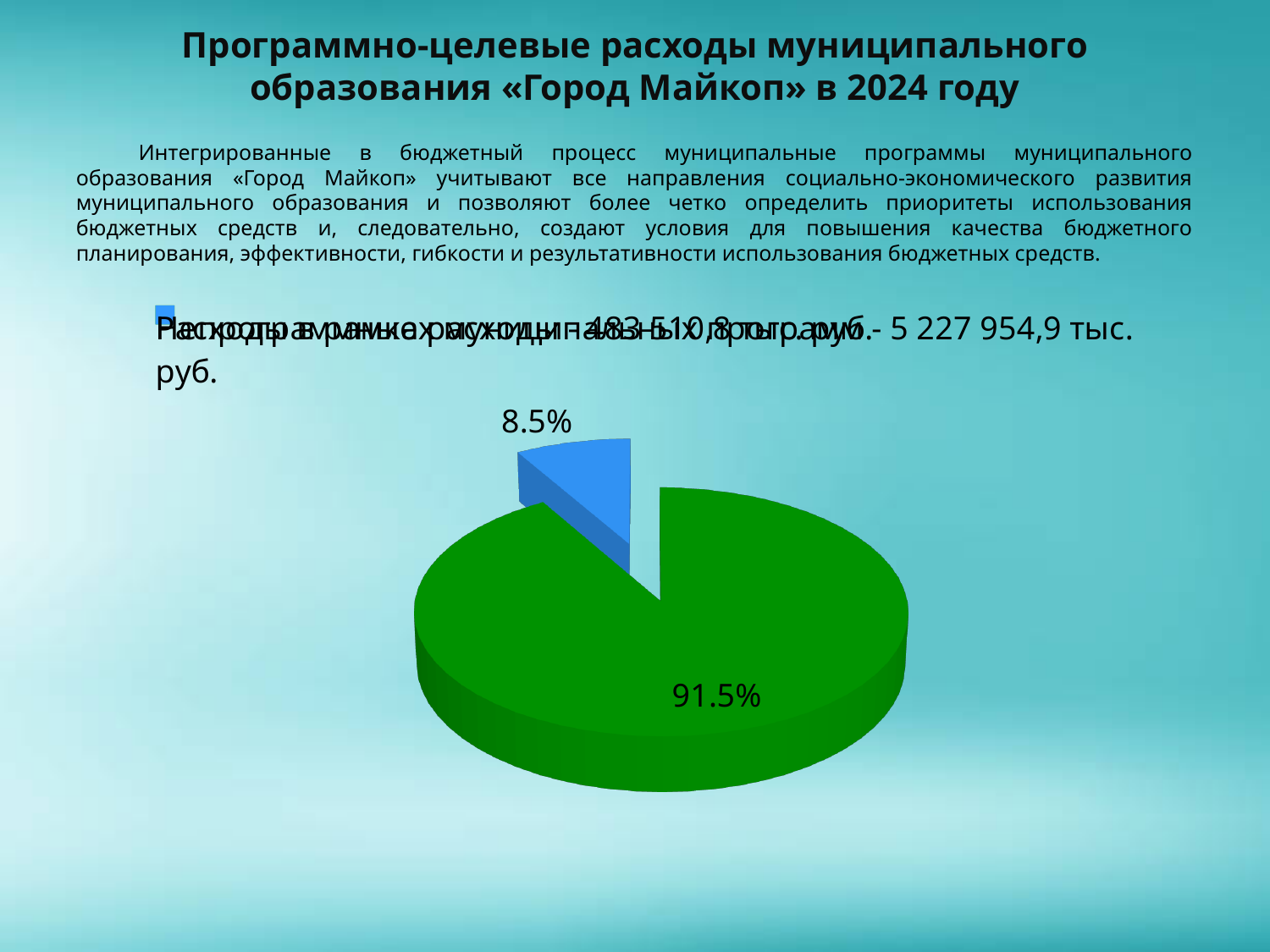
Is the value of the green slice greater or less than 90%? greater How many slices does the pie chart have? 2 Is the value of the blue slice greater or less than 10%? less What year is named in the slide title above the pie chart? 2024 What is the value of the smallest slice in the pie chart? 8.5% What percentage is shown on the green slice of the pie chart? 91.5% By how many percentage points does the green slice exceed the blue slice? 83 What kind of chart is shown on the slide? pie chart Which slice is larger, the green one or the blue one? green What percentage is shown on the blue slice of the pie chart? 8.5% What colour is the largest slice of the pie chart? green What is the value of the largest slice in the pie chart? 91.5%